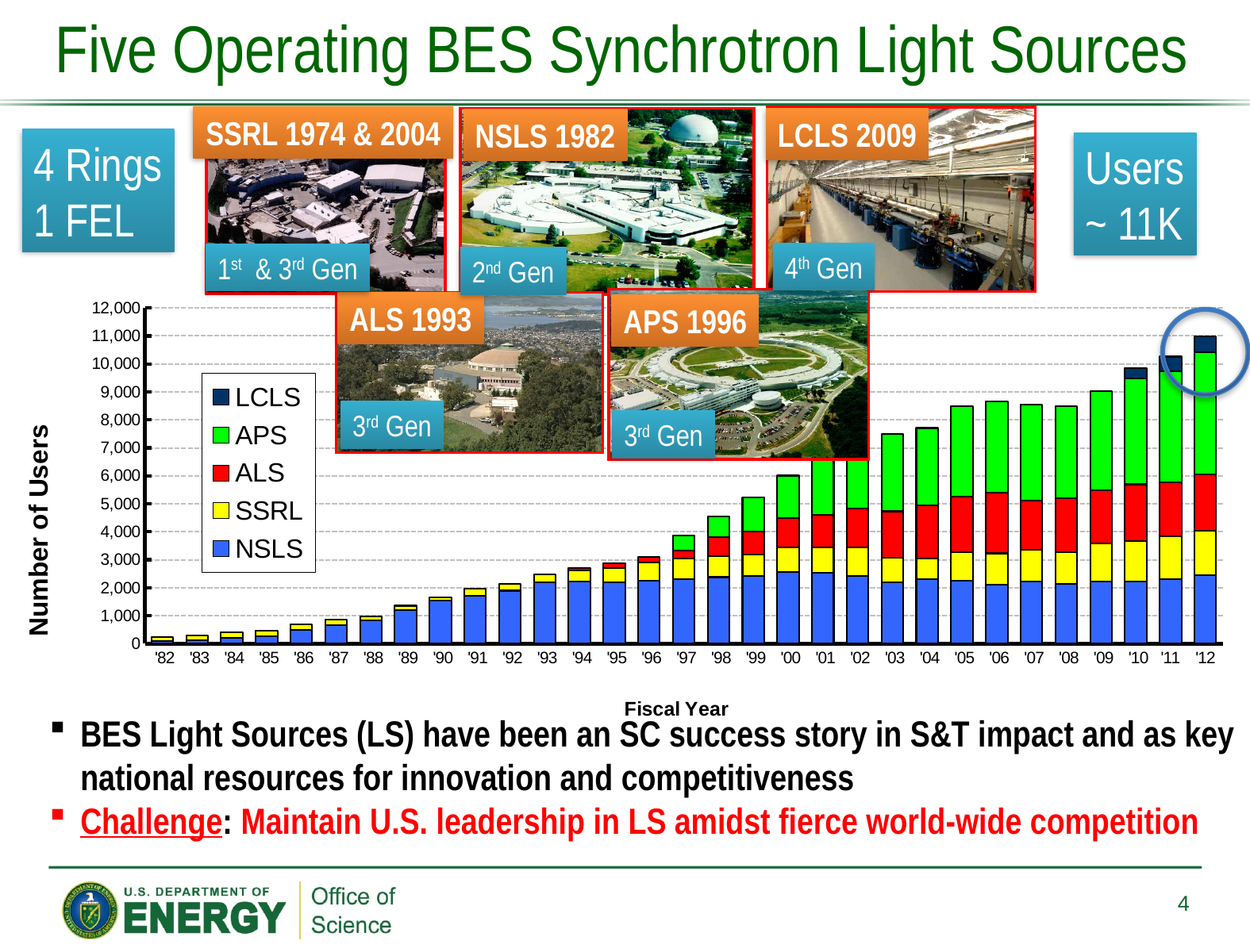
Is the total number of users in '82 greater or less than 1,000? less Which fiscal year has the tallest stacked bar in the chart? '12 Which fiscal year has the shortest stacked bar in the chart? '82 Is the total number of users in '12 greater or less than 10,000? greater How many fiscal years are plotted on the x axis of the chart? 31 What kind of chart is shown on the slide? stacked bar chart Which series is shown in green in the chart legend? APS Overall, do the total number of users rise or fall from '82 to '12? rise How many series does the chart legend list? 5 Which fiscal year has a larger total number of users, '98 or '08? '08 What is the label of the y axis of the chart? Number of Users Is the total number of users in '05 greater or less than 8,000? greater